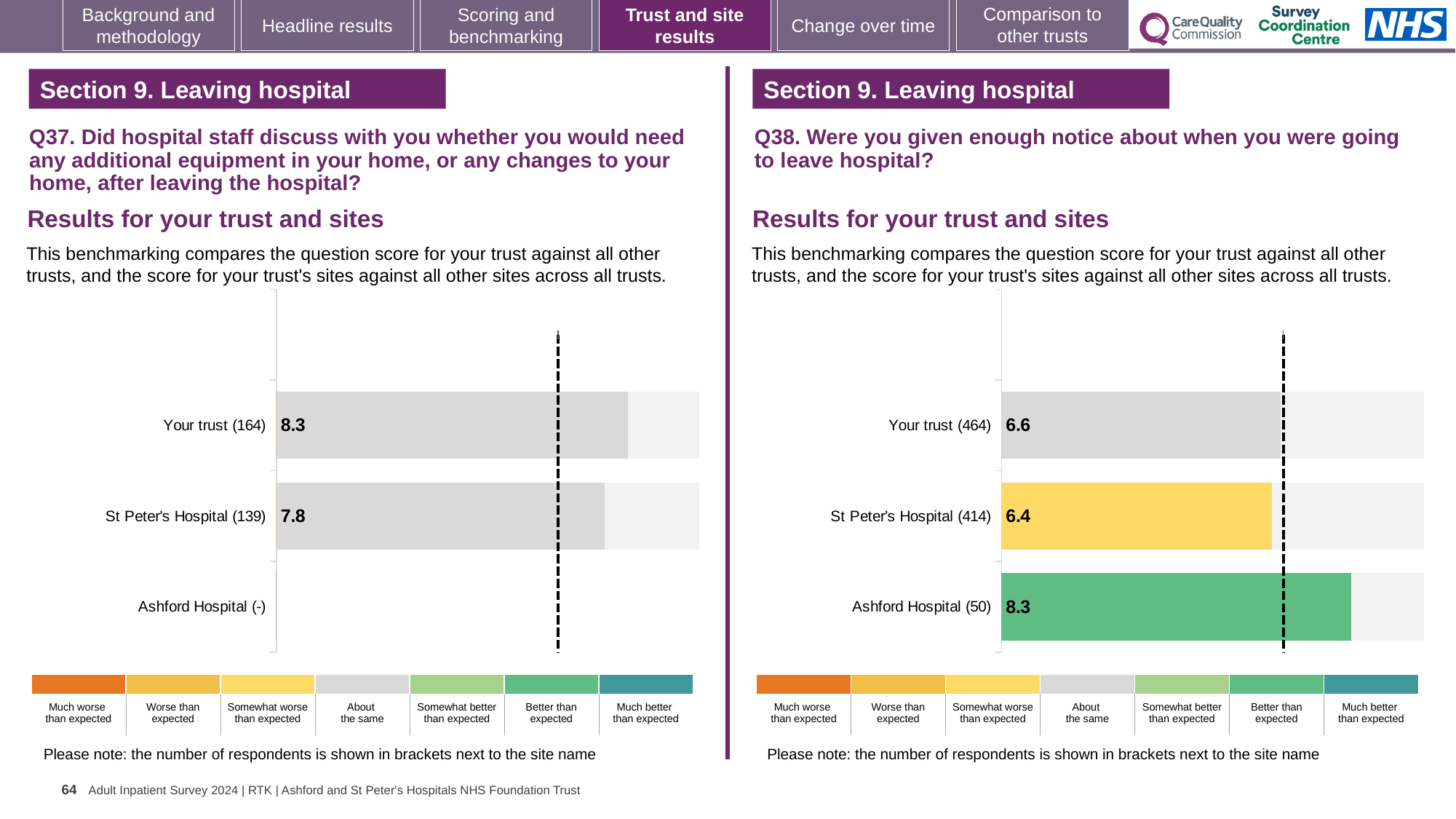
In the Q38 chart on the right, how many respondents are shown for Your trust? 464 In the Q37 chart on the left, what is the difference between the scores for Your trust and St Peter's Hospital? 0.5 In the Q38 chart on the right, which has the larger score, Your trust or St Peter's Hospital? Your trust In the Q38 chart on the right, which site or trust has the highest score? Ashford Hospital In the Q38 chart on the right, which benchmark category does the colour of the St Peter's Hospital bar correspond to? Somewhat worse than expected In the Q37 chart on the left, what is the score for St Peter's Hospital? 7.8 In the Q38 chart on the right, what is the score for St Peter's Hospital? 6.4 What type of chart is used in the Q37 chart on the left? Bar chart In the Q37 chart on the left, what is the score for Your trust? 8.3 In the Q38 chart on the right, what is the difference between the scores for Ashford Hospital and St Peter's Hospital? 1.9 In the Q38 chart on the right, what is the score for Ashford Hospital? 8.3 In the Q38 chart on the right, which site or trust has the lowest score? St Peter's Hospital